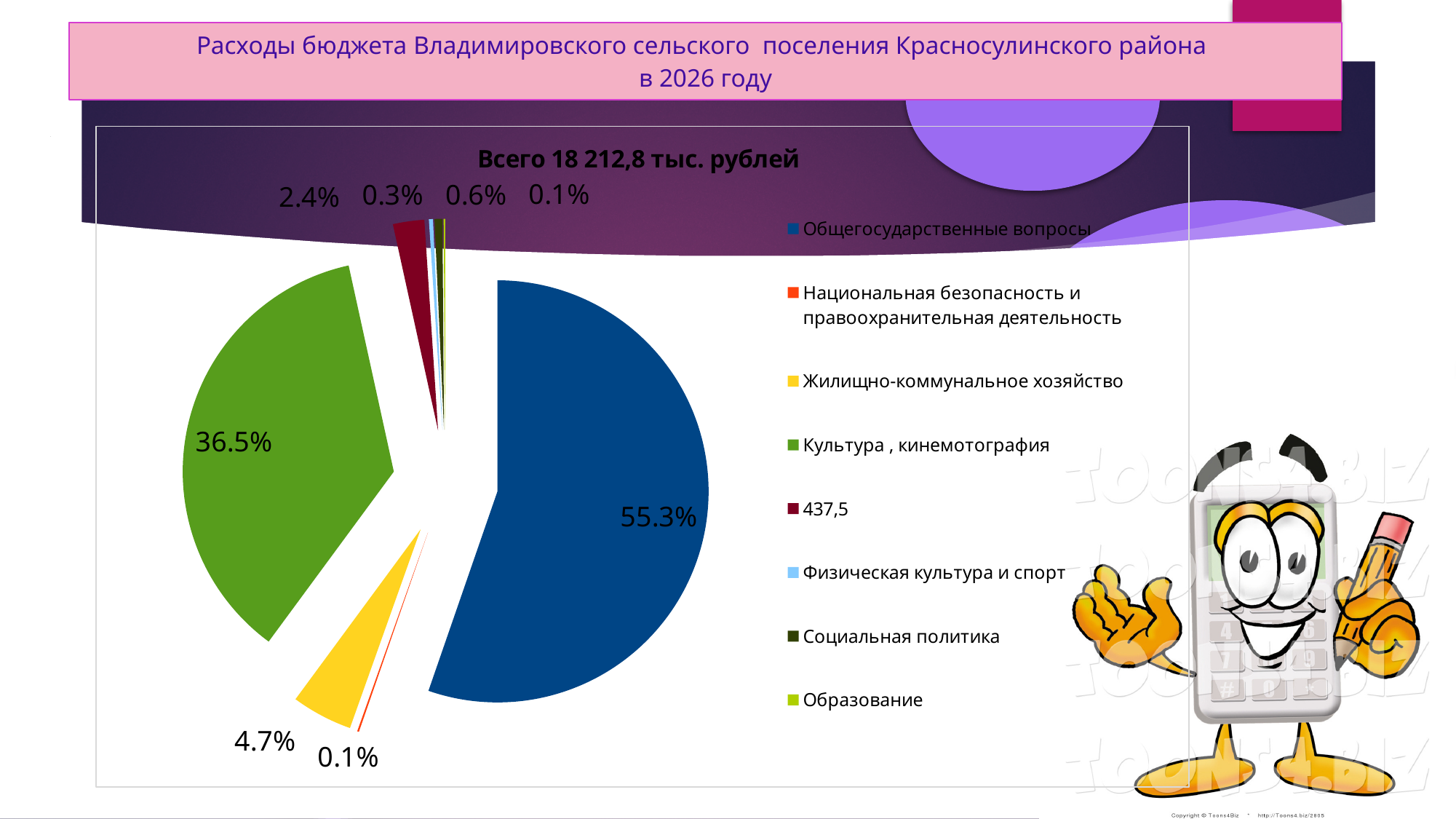
What is the combined share of Общегосударственные вопросы and Культура, кинемотография? 91.8% What total amount is stated in the chart title? 18 212,8 тыс. рублей Is the share for Культура, кинемотография greater or less than 50%? less By how many percentage points does the share for Общегосударственные вопросы exceed the share for Культура, кинемотография? 18.8 percentage points What share of the budget expenditure goes to Культура, кинемотография? 36.5% What share of the budget expenditure goes to Жилищно-коммунальное хозяйство? 4.7% How many entries does the legend of the pie chart list? 8 What kind of chart is shown on the slide? pie chart What colour is the slice for Общегосударственные вопросы? blue Which is larger: the share for Культура, кинемотография or the share for Жилищно-коммунальное хозяйство? Культура, кинемотография What share of the budget expenditure goes to Общегосударственные вопросы? 55.3% Which category has the largest share of the pie? Общегосударственные вопросы